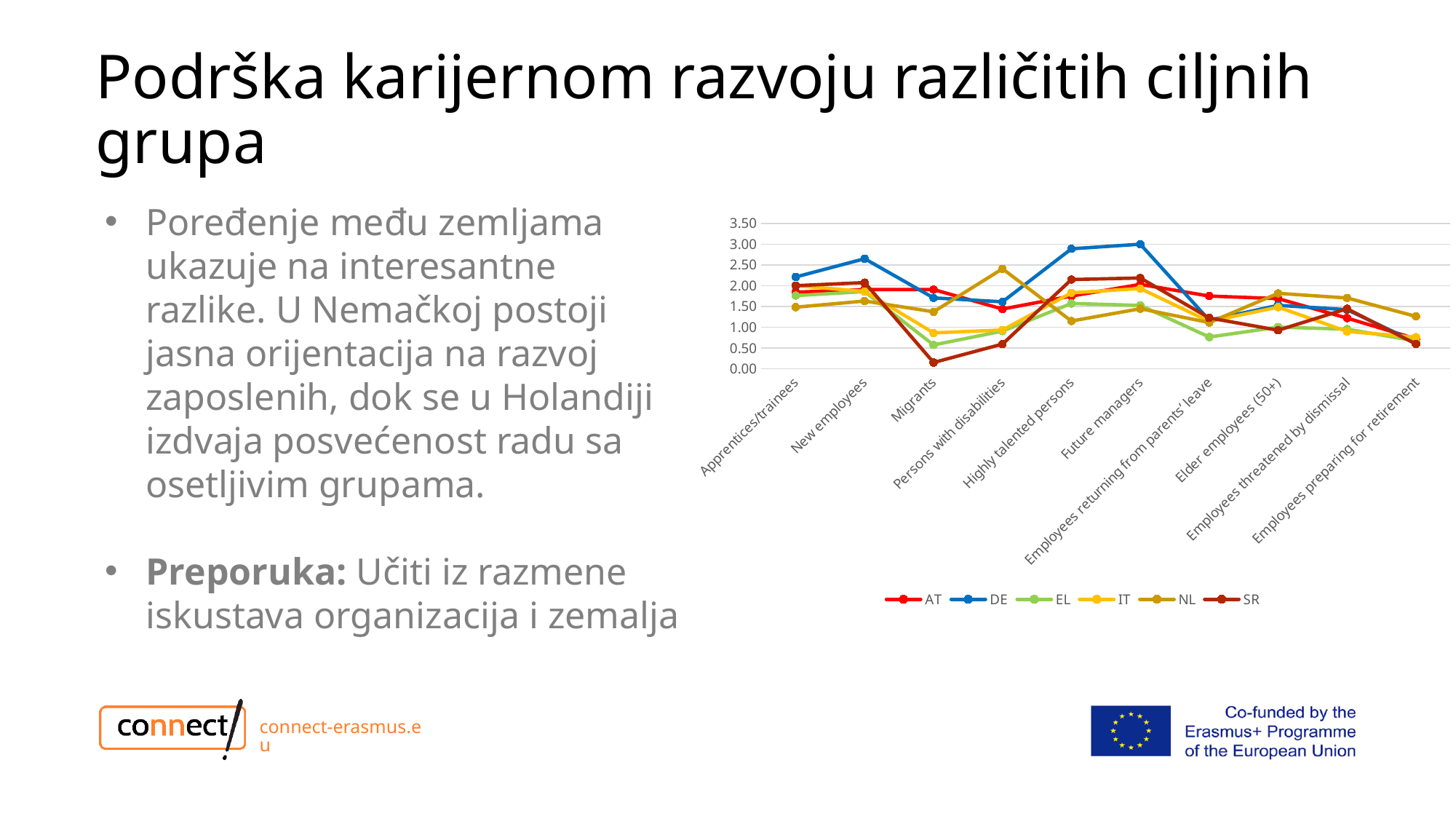
How many series does the chart legend list? 6 How many target-group categories are shown along the x axis of the chart? 10 Is the SR value for Migrants greater or less than 0.50? less For Migrants, which is larger: the NL value or the EL value? NL Which country series has the highest value for Future managers? DE For Highly talented persons, which is larger: the DE value or the AT value? DE Which country series has the highest value for Persons with disabilities? NL Is the DE value for Highly talented persons greater or less than 2.50? greater Which colour is used for the DE series in the chart? blue What kind of chart is shown on the slide? line chart Which country series has the lowest value for Migrants? SR Is the EL value for Employees returning from parents' leave greater or less than 1.00? less